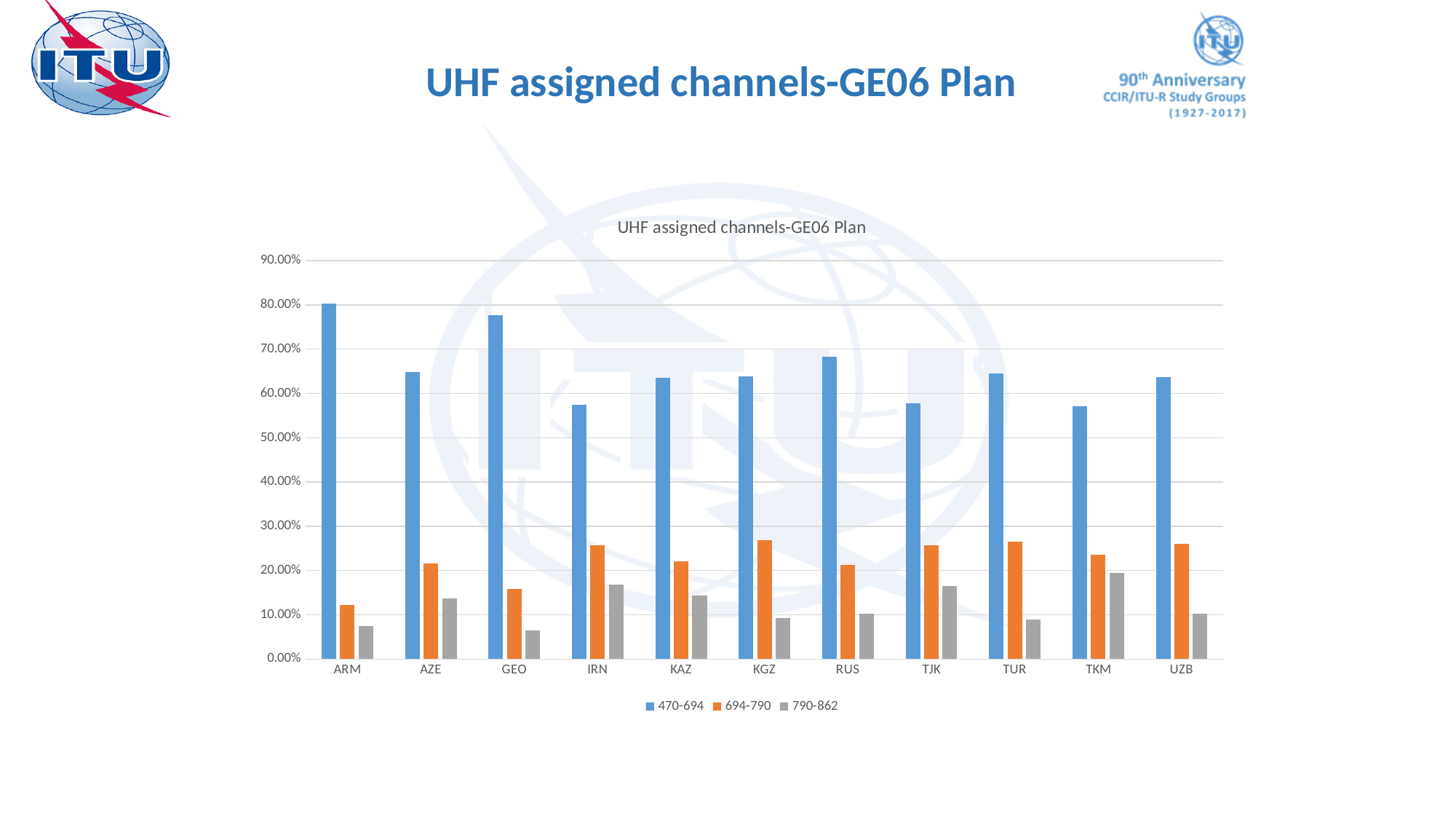
How many series does the chart legend list? 3 Is the 790-862 value for GEO greater or less than 10.00%? less Which country has the lowest value for the 694-790 series? ARM Which is larger for the 470-694 series: ARM or AZE? ARM What is the title of the chart? UHF assigned channels-GE06 Plan Is the 470-694 value for GEO greater or less than 70.00%? greater Which country has the highest value for the 790-862 series? TKM What kind of chart is shown on the slide? bar chart Is the 694-790 value for ARM greater or less than 20.00%? less Which is larger for the 790-862 series: IRN or KAZ? IRN How many countries are shown on the x axis of the chart? 11 Which country has the highest value for the 470-694 series? ARM